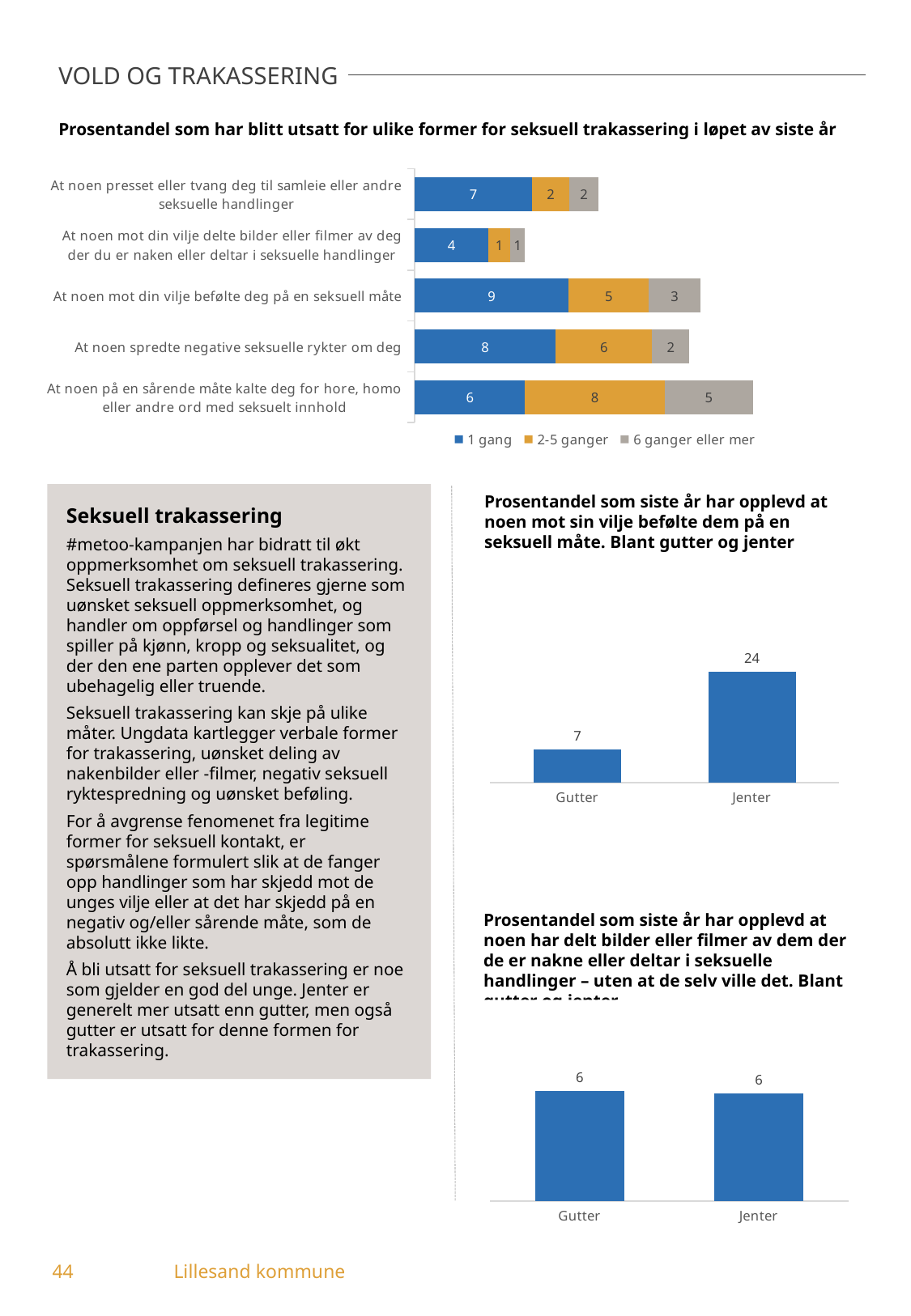
In the top chart, which category has the lowest value for '1 gang'? At noen mot din vilje delte bilder eller filmer av deg der du er naken eller deltar i seksuelle handlinger In the bottom chart about 'delt bilder eller filmer', which is larger, Gutter or Jenter? They are equal What kind of chart is the bottom chart about 'delt bilder eller filmer'? Bar chart In the top chart, how many series does the legend list? 3 In the top chart, what is the total of the stacked bar for 'At noen mot din vilje befølte deg på en seksuell måte'? 17 In the middle chart 'Prosentandel som siste år har opplevd at noen mot sin vilje befølte dem på en seksuell måte', what is the value for Jenter? 24 In the top chart 'Prosentandel som har blitt utsatt for ulike former for seksuell trakassering i løpet av siste år', what is the value for '1 gang' for 'At noen mot din vilje befølte deg på en seksuell måte'? 9 In the middle chart about 'befølte dem på en seksuell måte', what is the difference between Jenter and Gutter? 17 In the top chart, what is the total of the stacked bar for 'At noen mot din vilje delte bilder eller filmer av deg der du er naken eller deltar i seksuelle handlinger'? 6 In the top chart, how many categories are shown? 5 In the top chart, what is the difference between the '6 ganger eller mer' values for 'At noen på en sårende måte kalte deg for hore, homo eller andre ord med seksuelt innhold' and 'At noen spredte negative seksuelle rykter om deg'? 3 In the top chart, what is the value for '2-5 ganger' for 'At noen på en sårende måte kalte deg for hore, homo eller andre ord med seksuelt innhold'? 8